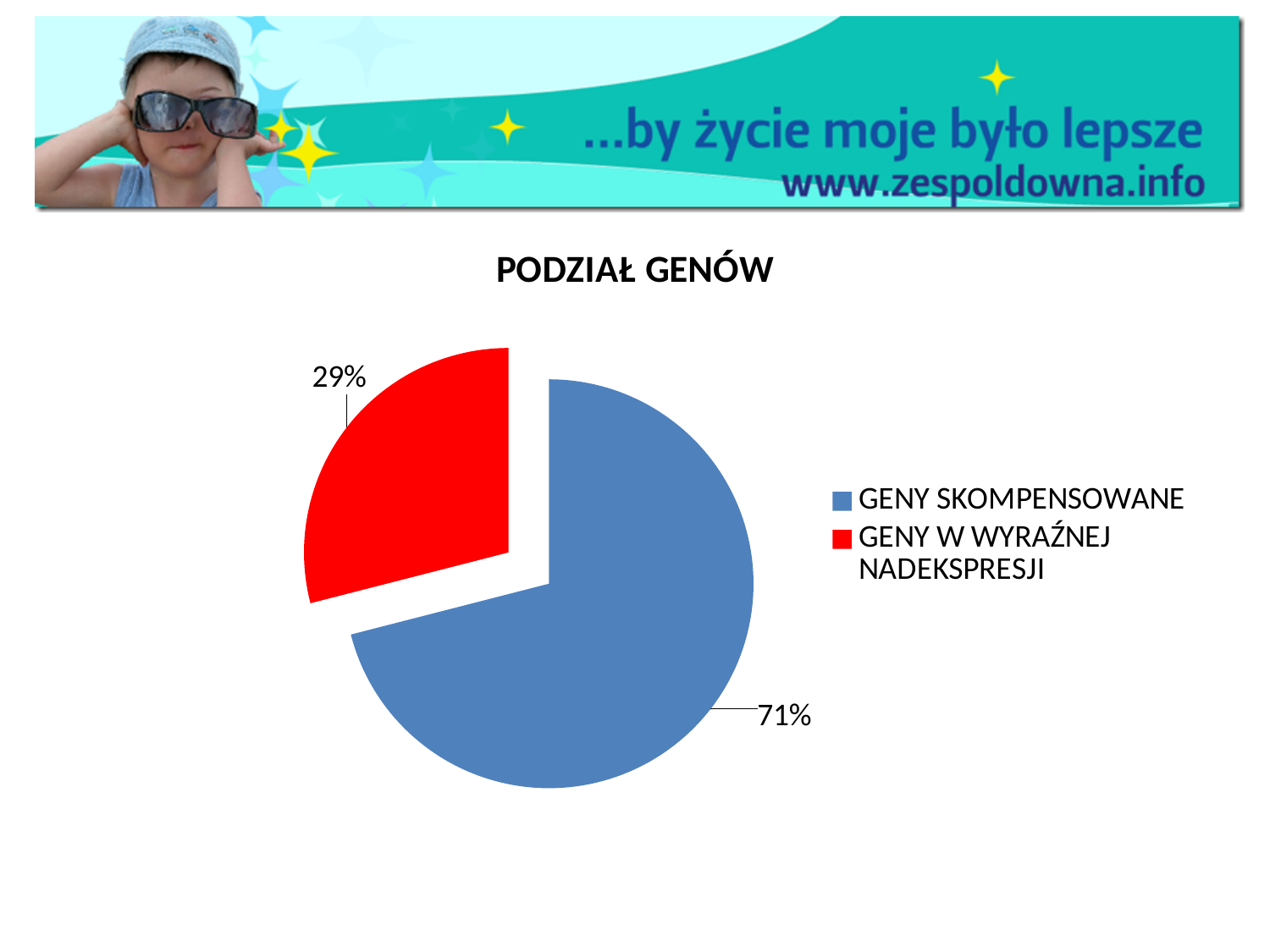
What is the value shown for the blue slice? 71% What colour is the slice for GENY W WYRAŹNEJ NADEKSPRESJI? red How many slices does the pie chart have? 2 What share of the pie is GENY SKOMPENSOWANE? 71% Which is larger: the share for GENY SKOMPENSOWANE or for GENY W WYRAŹNEJ NADEKSPRESJI? GENY SKOMPENSOWANE What is the value shown for the red slice? 29% What is the title of the chart? PODZIAŁ GENÓW What kind of chart is shown on the slide? pie chart Which category has the largest slice of the pie? GENY SKOMPENSOWANE What share of the pie is GENY W WYRAŹNEJ NADEKSPRESJI? 29% Which category has the smallest slice of the pie? GENY W WYRAŹNEJ NADEKSPRESJI What is the difference in percentage points between GENY SKOMPENSOWANE and GENY W WYRAŹNEJ NADEKSPRESJI? 42